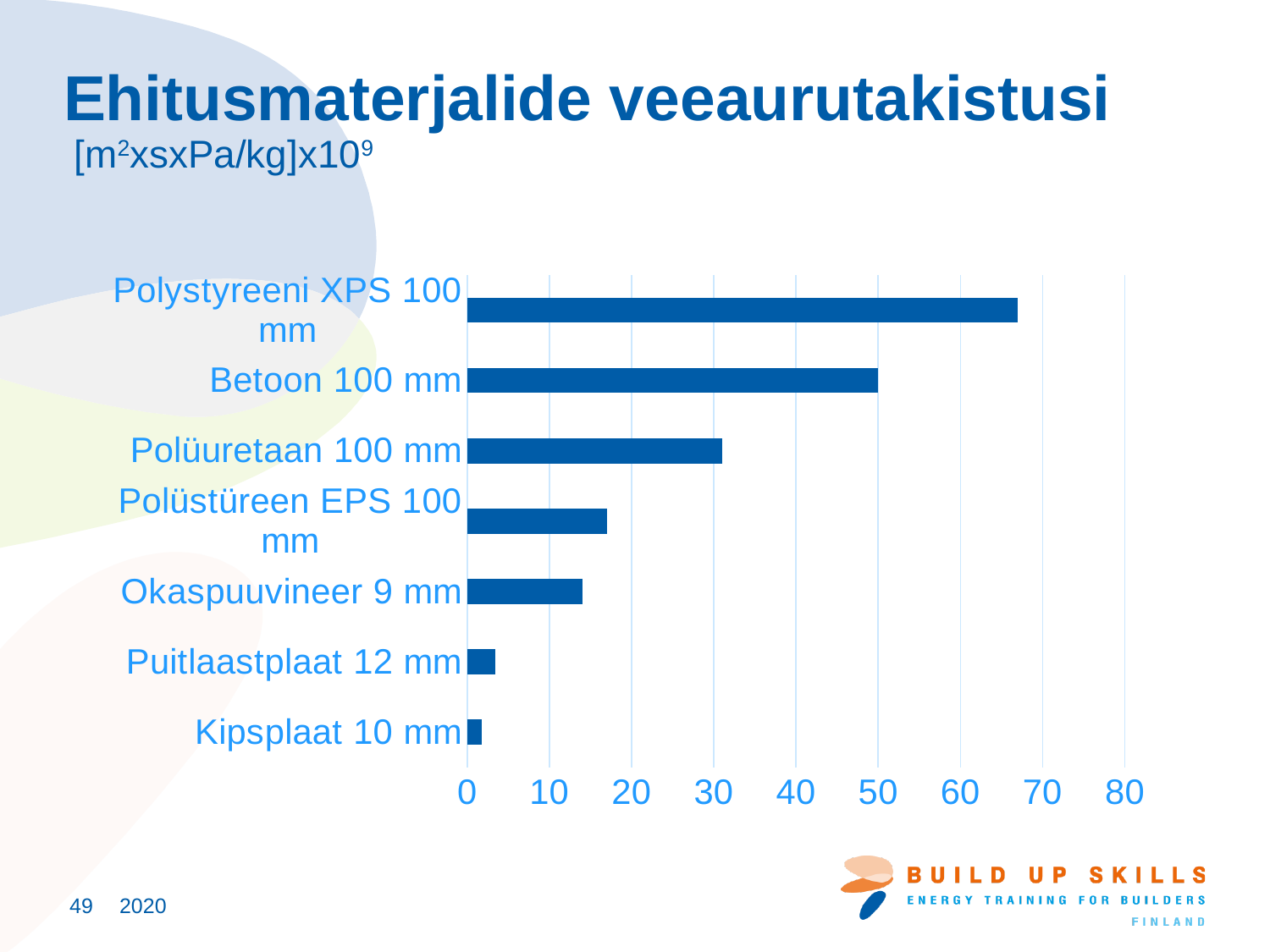
What kind of chart is shown on the slide? bar chart Is the value for Polüuretaan 100 mm greater or less than 40? less What is the title of the slide containing the chart? Ehitusmaterjalide veeaurutakistusi What is the highest value shown on the horizontal axis of the chart? 80 Which material has the lowest value in the chart? Kipsplaat 10 mm Which material has the highest value in the chart? Polystyreeni XPS 100 mm How many materials (categories) are plotted in the chart? 7 Is the value for Puitlaastplaat 12 mm greater or less than 10? less Which has the larger value, Betoon 100 mm or Polüuretaan 100 mm? Betoon 100 mm Is the value for Polüstüreen EPS 100 mm greater or less than 10? greater Which has the larger value, Okaspuuvineer 9 mm or Puitlaastplaat 12 mm? Okaspuuvineer 9 mm